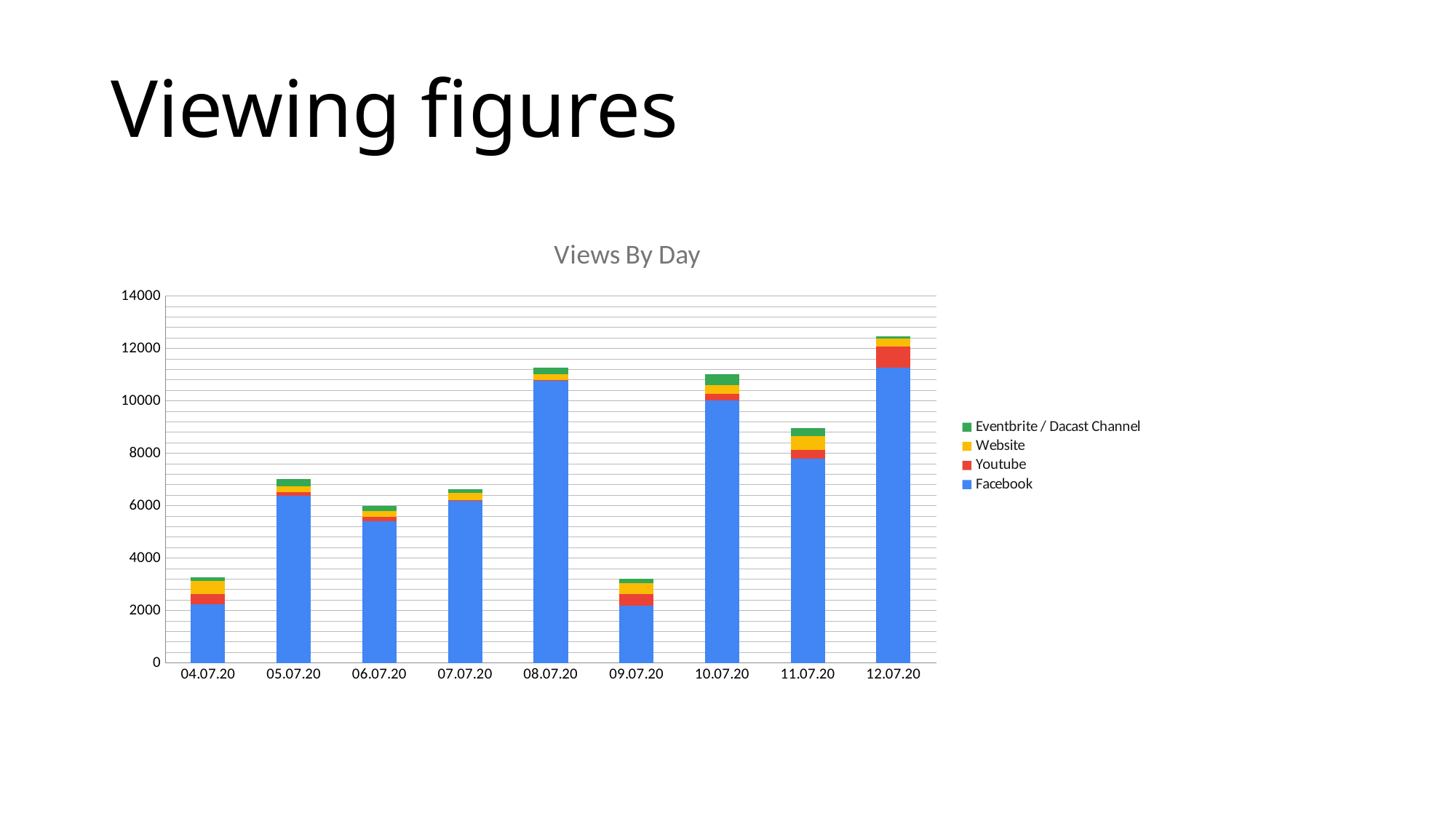
Which series is shown in blue? Facebook What type of chart is shown on the slide? Stacked bar chart How many dates are shown on the x axis? 9 Which has the larger total, 05.07.20 or 06.07.20? 05.07.20 Is the total for 04.07.20 greater or less than 4000? less Is the total for 11.07.20 greater or less than 8000? greater Which has the larger total, 10.07.20 or 11.07.20? 10.07.20 Is the Facebook value for 12.07.20 greater or less than 10000? greater How many series does the legend list? 4 Which date has the highest total views? 12.07.20 What is the title of the chart? Views By Day